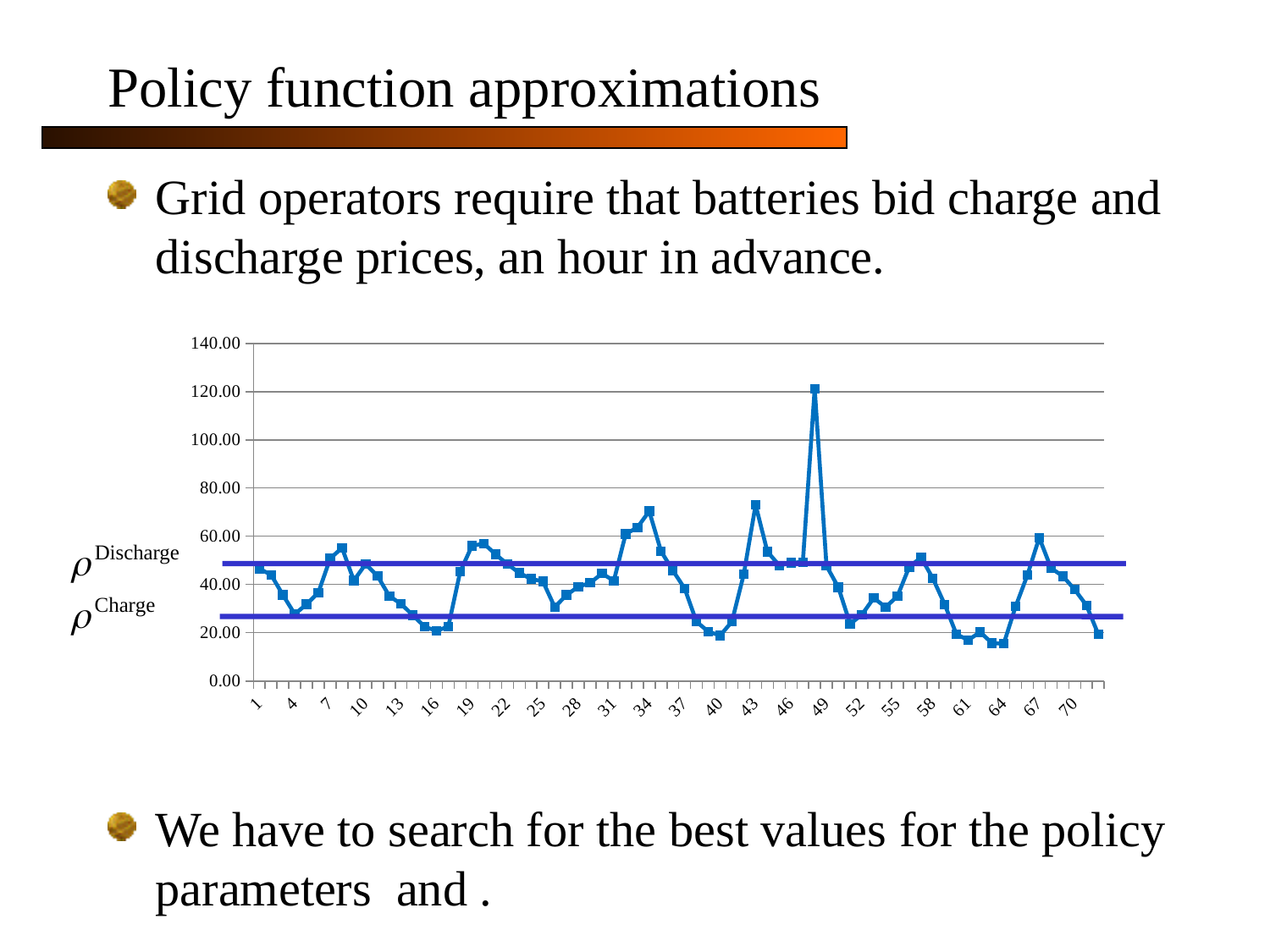
What kind of chart is shown on the slide? line chart Does the line rise or fall between x = 46 and x = 49 before the peak? rise Which of the two horizontal reference lines is higher, ρ Discharge or ρ Charge? ρ Discharge How many horizontal reference lines are drawn across the chart? 2 Which is larger, the value at x = 16 or the value at x = 19? x = 19 Is the value at x = 16 greater or less than 40? less Is the value at x = 19 greater or less than 40? greater Is the value at x = 64 greater or less than 20? less Between which two x-axis labels does the line reach its highest value? 46 and 49 What is the highest value shown on the y axis of the chart? 140.00